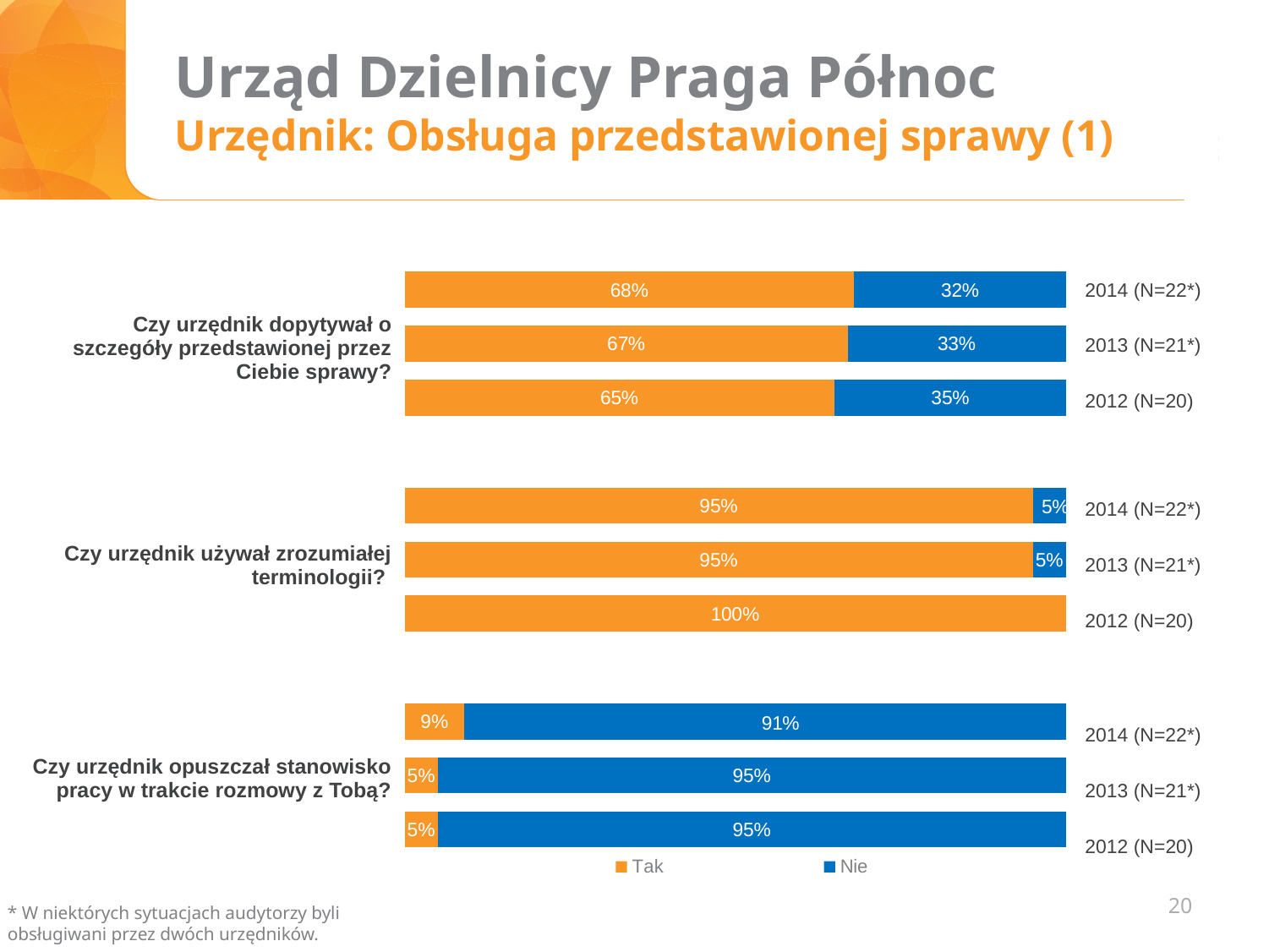
What is the 'Nie' value for 2012 (N=20) for the question 'Czy urzędnik dopytywał o szczegóły przedstawionej przez Ciebie sprawy?' 35% For the question 'Czy urzędnik opuszczał stanowisko pracy w trakcie rozmowy z Tobą?', is the 'Tak' value for 2014 (N=22*) larger or smaller than the 'Tak' value for 2013 (N=21*)? Larger What kind of chart is shown on the slide? Stacked bar chart For the question 'Czy urzędnik dopytywał o szczegóły przedstawionej przez Ciebie sprawy?', which year has the highest 'Tak' value? 2014 (N=22*) What is the 'Nie' value for 2014 (N=22*) for the question 'Czy urzędnik opuszczał stanowisko pracy w trakcie rozmowy z Tobą?' 91% What is the difference between the 'Tak' values for 2014 (N=22*) and 2012 (N=20) for the question 'Czy urzędnik dopytywał o szczegóły przedstawionej przez Ciebie sprawy?' 3% How many bars are plotted on the chart in total? 9 What is the 'Tak' value for 2012 (N=20) for the question 'Czy urzędnik używał zrozumiałej terminologii?' 100% For the question 'Czy urzędnik opuszczał stanowisko pracy w trakcie rozmowy z Tobą?', which year has the lowest 'Nie' value? 2014 (N=22*) What are the two series named in the legend? Tak and Nie How many series does the legend list? 2 What is the 'Tak' value for 2014 (N=22*) for the question 'Czy urzędnik dopytywał o szczegóły przedstawionej przez Ciebie sprawy?' 68%